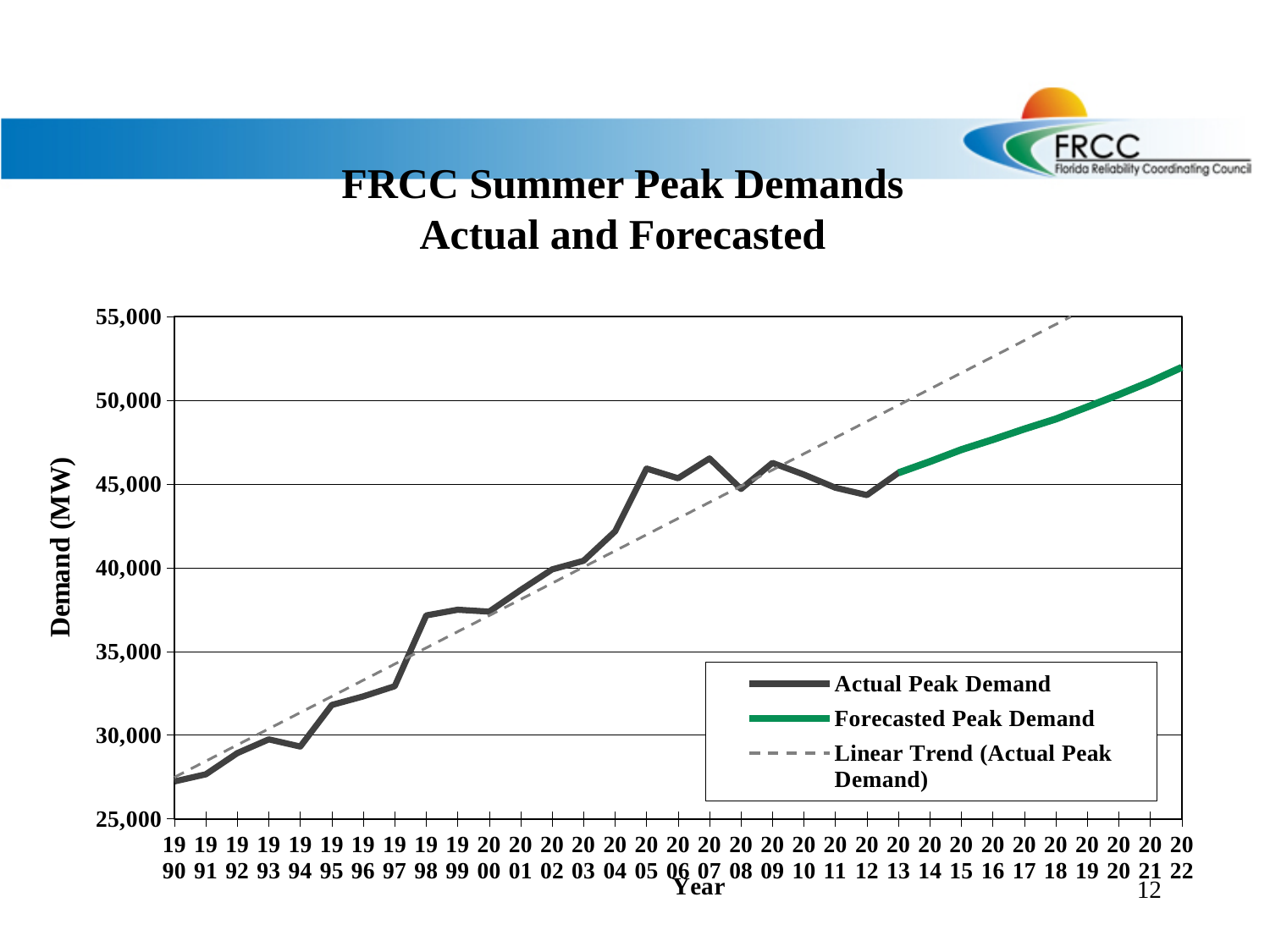
Does the Actual Peak Demand generally rise or fall from 1990 to 2013? rise Is the Actual Peak Demand for 2012 greater or less than 45,000? less Which is larger, the Actual Peak Demand for 2007 or for 2012? 2007 Which year has the highest Forecasted Peak Demand? 2022 What colour is the Forecasted Peak Demand line? green What kind of chart is shown on the slide? line chart Which year has the lowest Actual Peak Demand? 1990 How many series does the legend list? 3 Is the Actual Peak Demand for 1990 greater or less than 30,000? less Is the Forecasted Peak Demand for 2022 greater or less than 50,000? greater How many years are shown along the x axis? 33